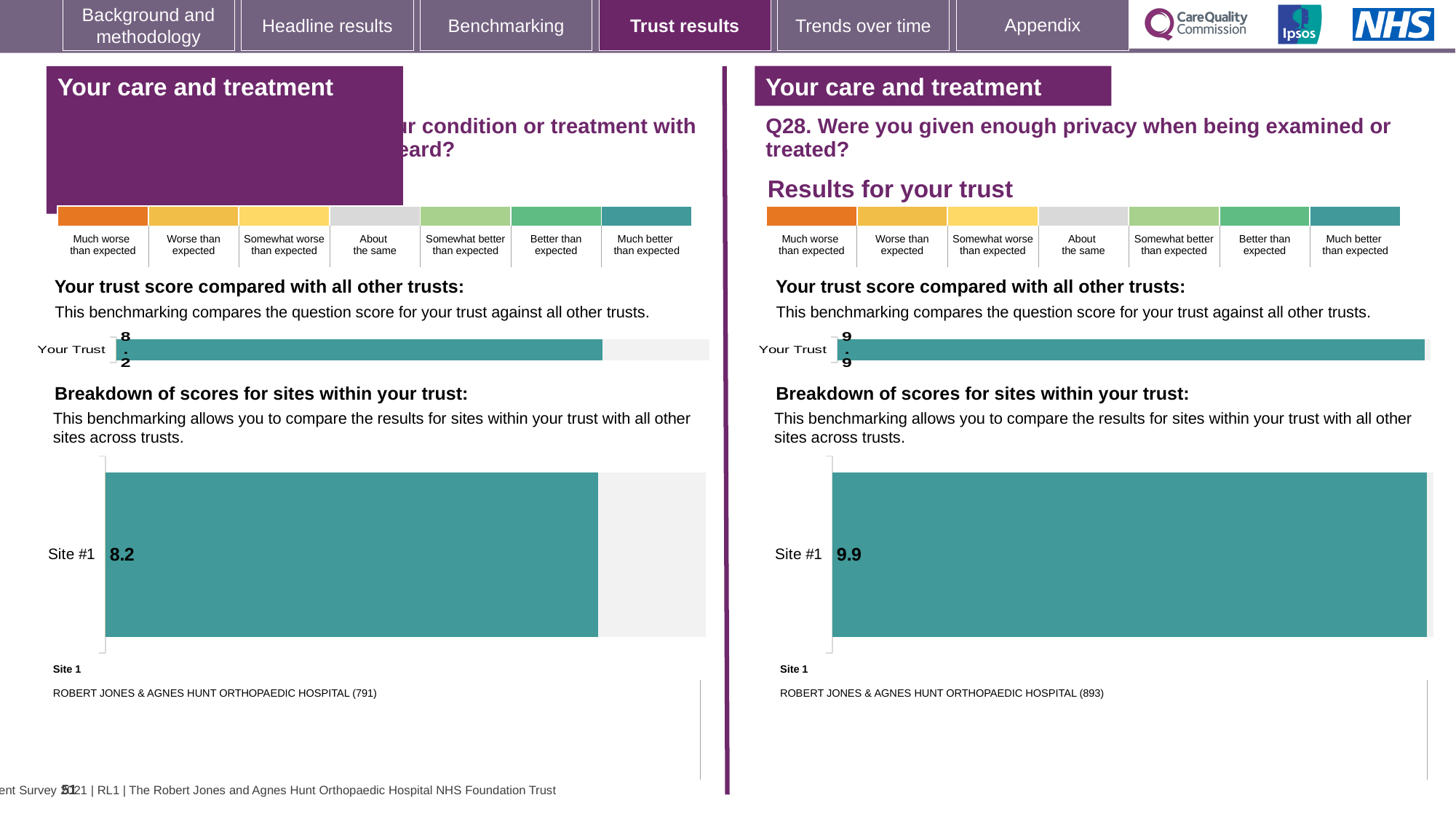
On the left-hand chart, what is the score shown for Site #1 in the breakdown of scores for sites? 8.2 On the right-hand chart for Q28, which site is listed as Site 1? ROBERT JONES & AGNES HUNT ORTHOPAEDIC HOSPITAL (893) On the left-hand chart, what is the score shown for Your Trust? 8.2 On the right-hand chart for Q28, what is the score shown for Site #1? 9.9 Which is larger: the Site #1 score on the left-hand chart or the Site #1 score on the right-hand chart for Q28? Right-hand chart (Q28) How many sites are shown in the breakdown of scores for sites on the right-hand chart for Q28? 1 Is the Your Trust score on the left-hand chart greater or less than the Your Trust score on the right-hand chart for Q28? less On the left-hand chart, which site is listed as Site 1? ROBERT JONES & AGNES HUNT ORTHOPAEDIC HOSPITAL (791) What kind of chart is used to show the Site #1 score on the right-hand chart for Q28? Bar chart On the right-hand chart for Q28 (privacy when being examined or treated), what is the score shown for Your Trust? 9.9 What is the difference between the Your Trust score on the right-hand chart for Q28 and the Your Trust score on the left-hand chart? 1.7 How many sites are shown in the breakdown of scores for sites on the left-hand chart? 1